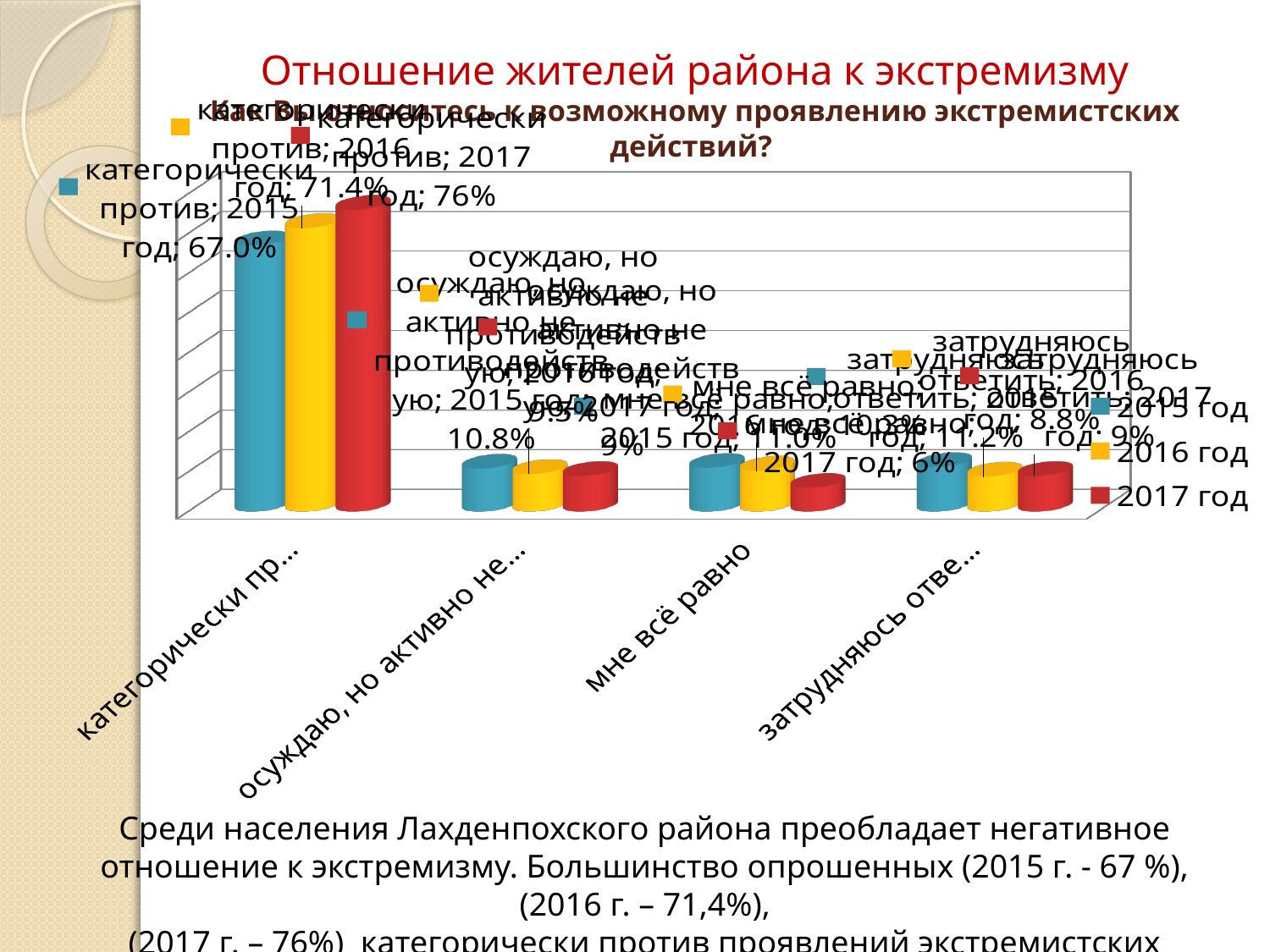
What is the value for 'категорически против' in 2016 год? 71.4% What is the value for 'категорически против' in 2017 год? 76% Which year has the highest value for 'категорически против'? 2017 год Do the values for 'категорически против' rise or fall from 2015 год to 2017 год? rise What kind of chart is shown on the slide? bar chart What is the difference between the 2017 год and 2015 год values for 'категорически против'? 9% Which is larger for 'мне всё равно': the 2015 год value or the 2017 год value? 2015 год How many series does the legend list? 3 Which category has the highest values across all three years? категорически против Which colour represents the series '2017 год' in the legend? red How many categories are shown on the x axis of the chart? 4 What is the value for 'категорически против' in 2015 год? 67.0%